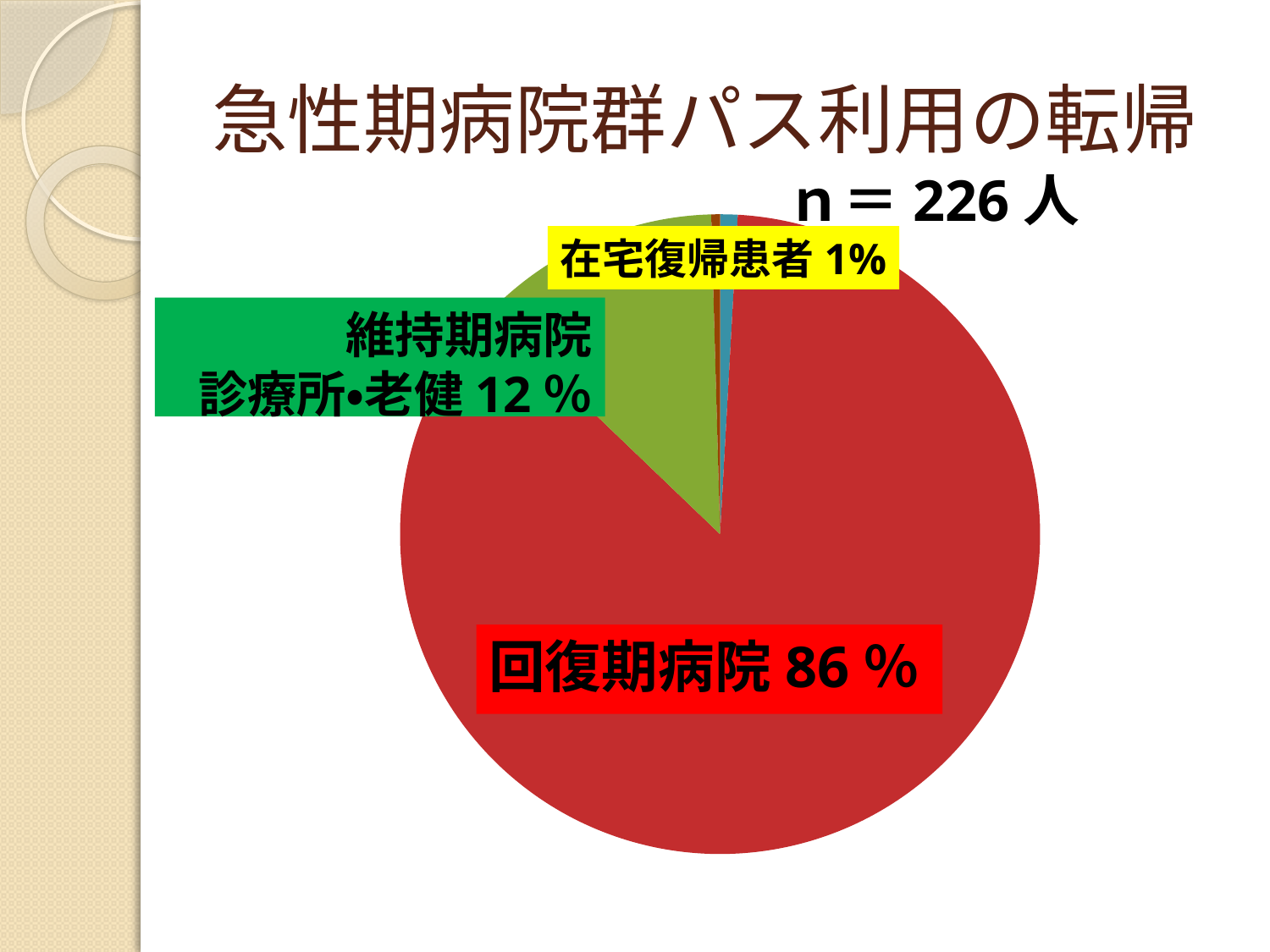
What is the title of the slide? 急性期病院群パス利用の転帰 Which is larger, the share for 回復期病院 or the share for 維持期病院 診療所•老健? 回復期病院 Which category has the largest slice of the pie? 回復期病院 What is the difference in percentage points between 維持期病院 診療所•老健 and 在宅復帰患者? 11 Which labeled category has the smallest slice of the pie? 在宅復帰患者 What percentage is shown for 在宅復帰患者? 1% What kind of chart is shown on the slide? pie chart What share of the pie does 回復期病院 account for? 86 % What is the difference in percentage points between 回復期病院 and 維持期病院 診療所•老健? 74 What is the sample size (n) shown on the slide? 226 人 What percentage is shown for 維持期病院 診療所•老健? 12 %